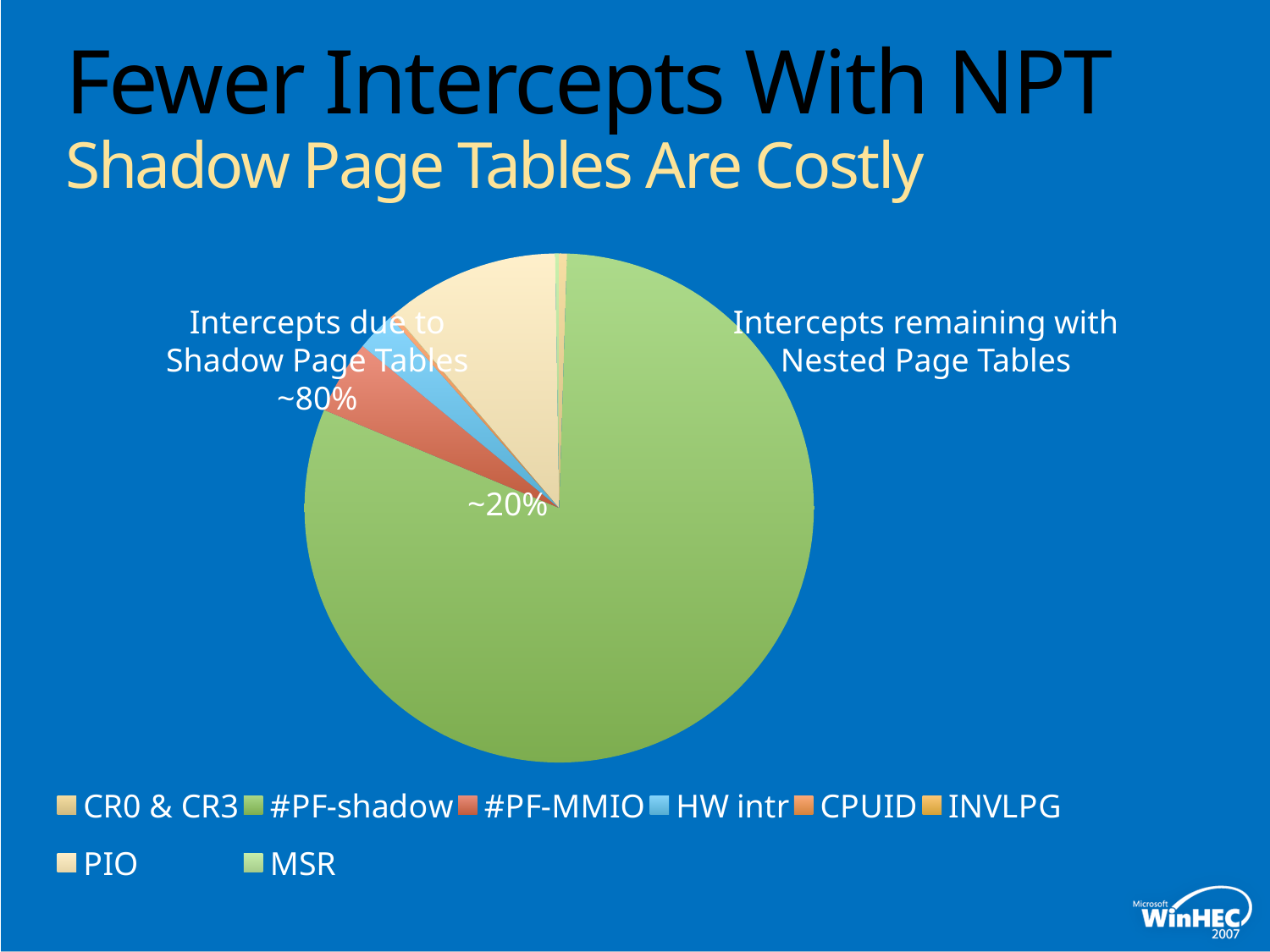
Which slice is larger, #PF-shadow or PIO? #PF-shadow Which slice is larger, PIO or #PF-MMIO? PIO What colour is the #PF-shadow slice in the pie chart? green Which category has the largest slice of the pie chart? #PF-shadow Which slice is larger, #PF-MMIO or HW intr? #PF-MMIO What kind of chart is shown on the slide? pie chart How many categories does the legend of the pie chart list? 8 What is the title of the slide containing the pie chart? Fewer Intercepts With NPT